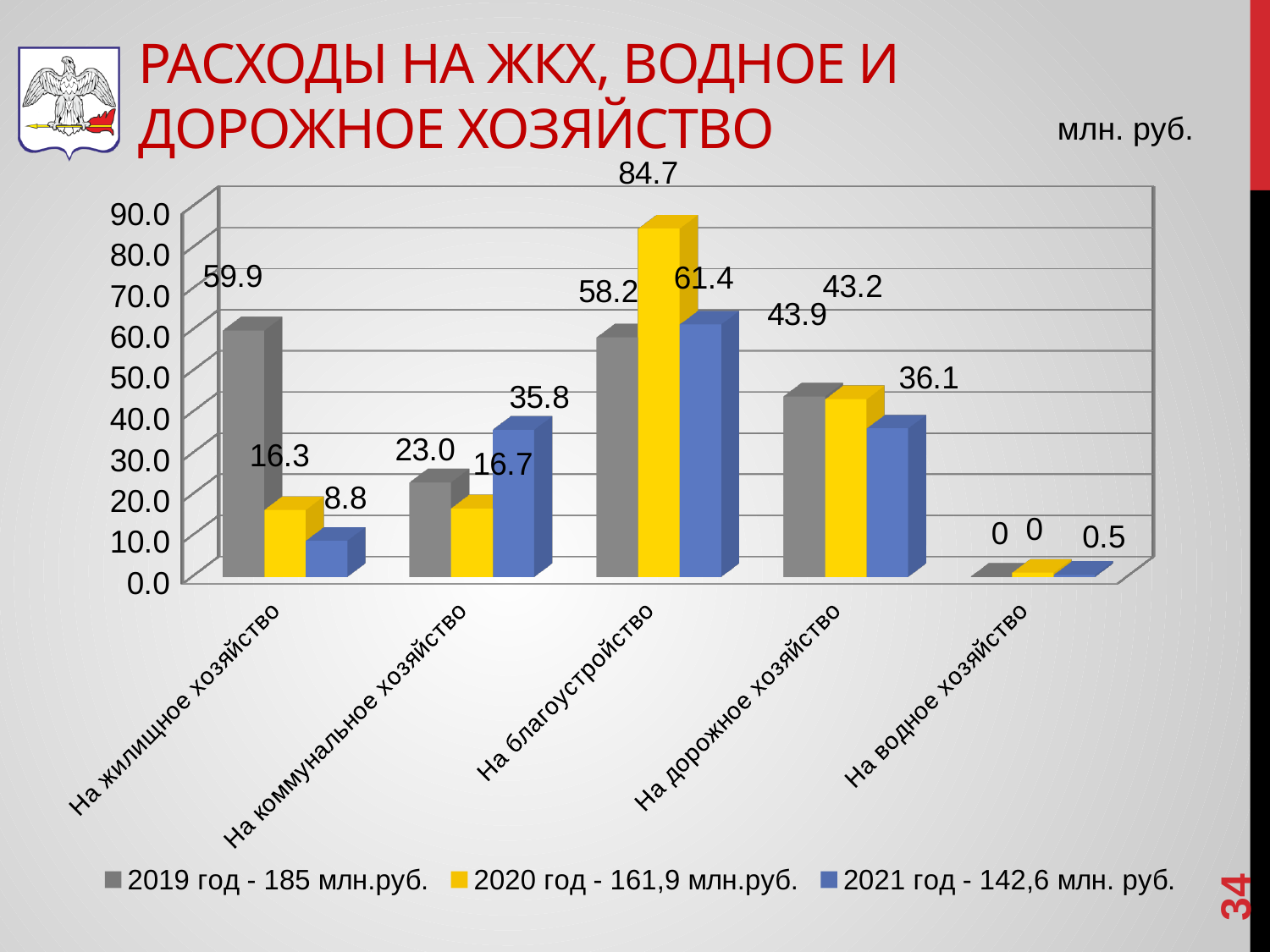
What unit is indicated for the values on the chart? млн. руб. What kind of chart is shown on the slide? Bar chart What is the value for На водное хозяйство in the 2021 series? 0.5 What is the difference between the 2019 and 2021 values for На жилищное хозяйство? 51.1 What is the value for На жилищное хозяйство in the 2019 series? 59.9 Which category has the highest value in the 2020 series? На благоустройство Which category has the lowest value in the 2019 series? На водное хозяйство What is the value for На коммунальное хозяйство in the 2021 series? 35.8 Which is larger for На коммунальное хозяйство: the 2019 value or the 2021 value? 2021 What is the value for На благоустройство in the 2020 series? 84.7 How many series does the legend list? 3 How many categories are shown on the x axis? 5